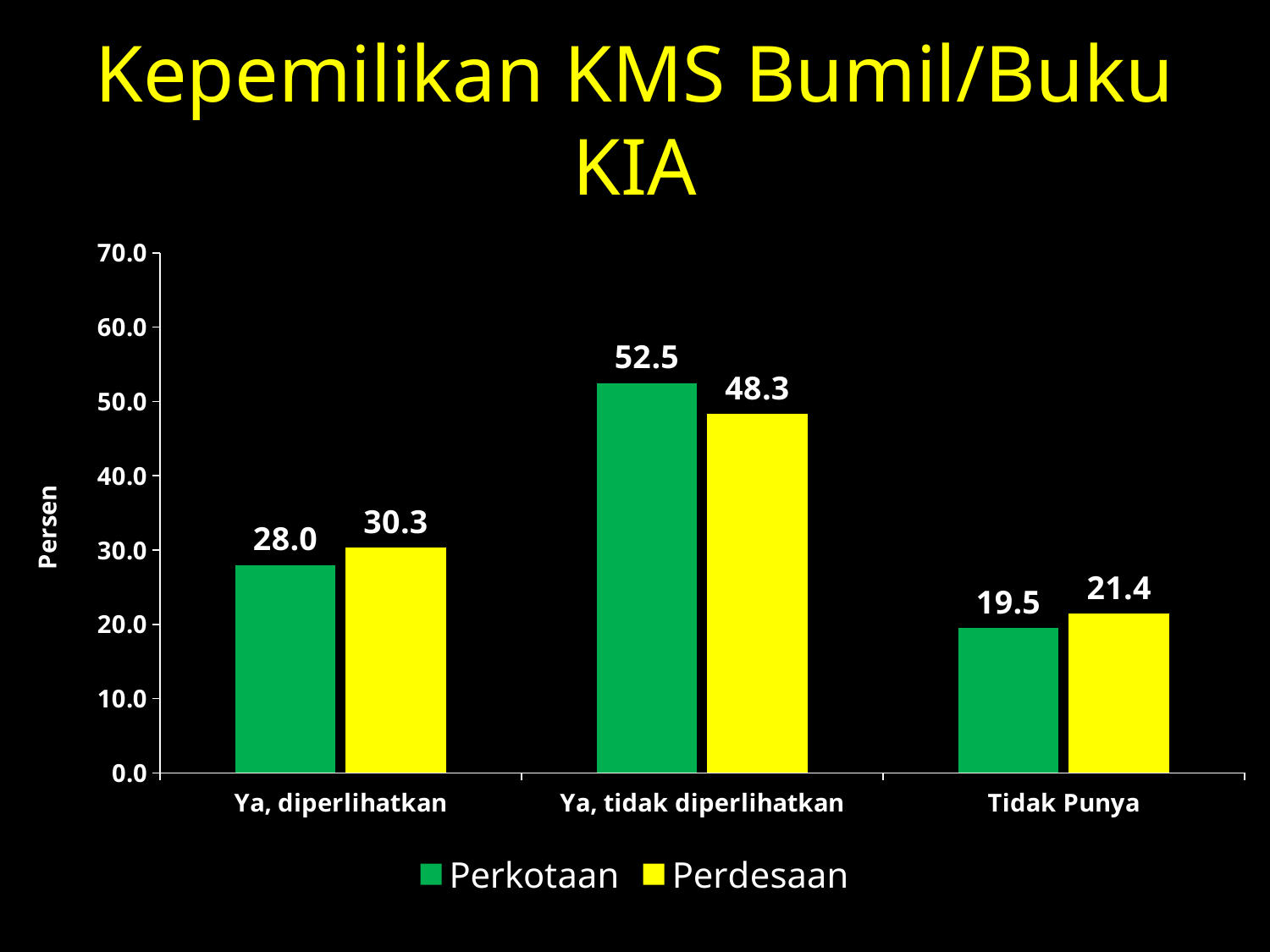
What is the difference between the Perkotaan and Perdesaan values for "Ya, tidak diperlihatkan"? 4.2 How many series does the legend list? 2 What is the Perdesaan value for "Tidak Punya"? 21.4 How many categories are shown on the x axis? 3 Which category has the lowest Perdesaan value? Tidak Punya What is the label of the y axis? Persen What is the Perdesaan value for "Ya, tidak diperlihatkan"? 48.3 For "Ya, diperlihatkan", which is larger: Perkotaan or Perdesaan? Perdesaan Which category has the highest Perkotaan value? Ya, tidak diperlihatkan What kind of chart is shown on the slide? bar chart Is the Perkotaan value for "Tidak Punya" greater or less than 20.0? less What is the Perkotaan value for "Ya, diperlihatkan"? 28.0